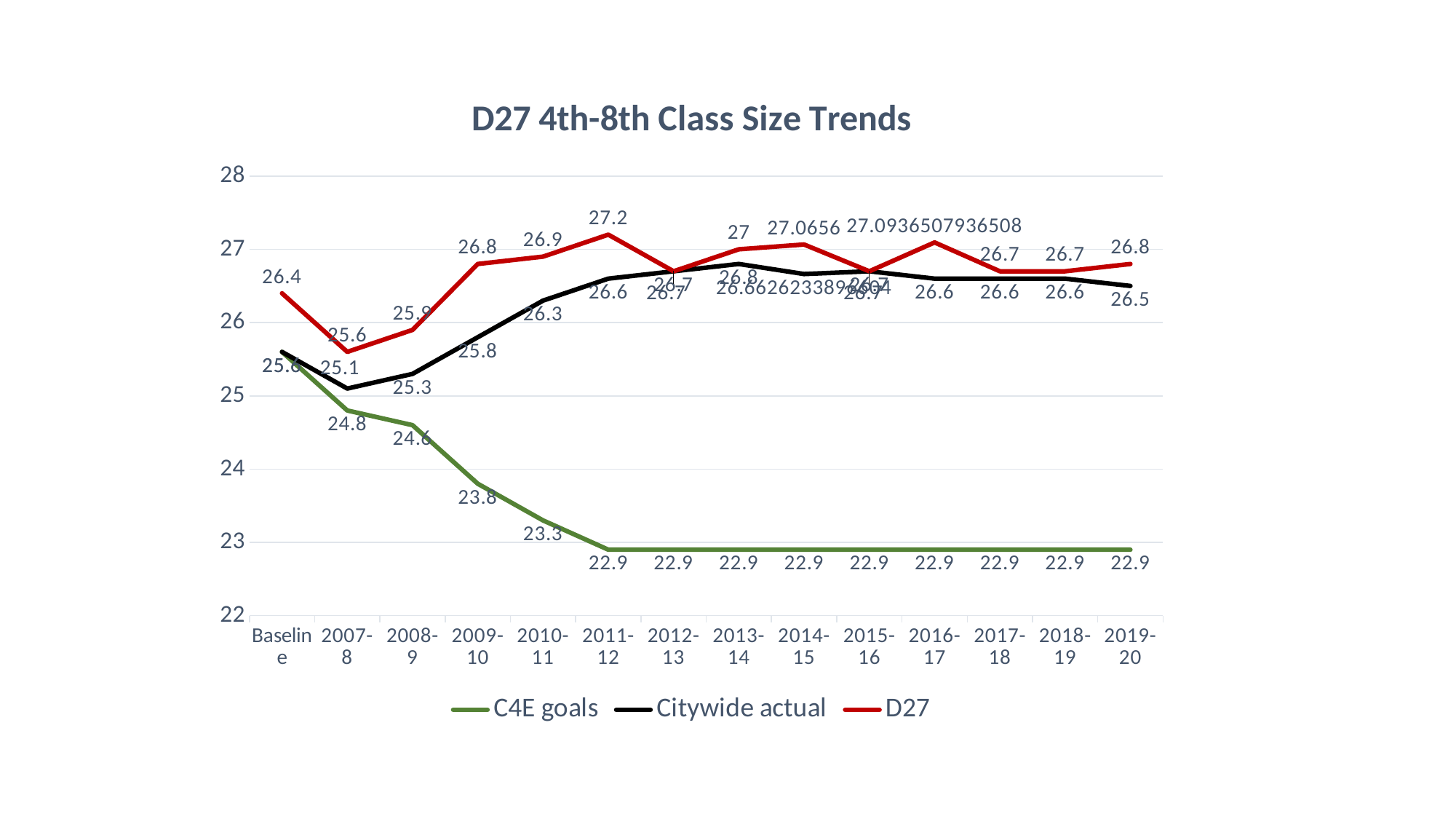
What is the title of the chart? D27 4th-8th Class Size Trends How many categories are shown along the x axis? 14 What is the D27 value for 2011-12? 27.2 Is the C4E goals value for 2019-20 greater or less than 24? less In which year does the D27 series reach its highest value? 2011-12 What is the difference between the D27 and Citywide actual values in 2019-20? 0.3 In which year is the Citywide actual series at its lowest value? 2007-8 In 2009-10, which is larger: the D27 value or the Citywide actual value? D27 How many series does the legend list? 3 What is the Citywide actual value for 2019-20? 26.5 What type of chart is shown on the slide? line chart What is the C4E goals value for 2010-11? 23.3